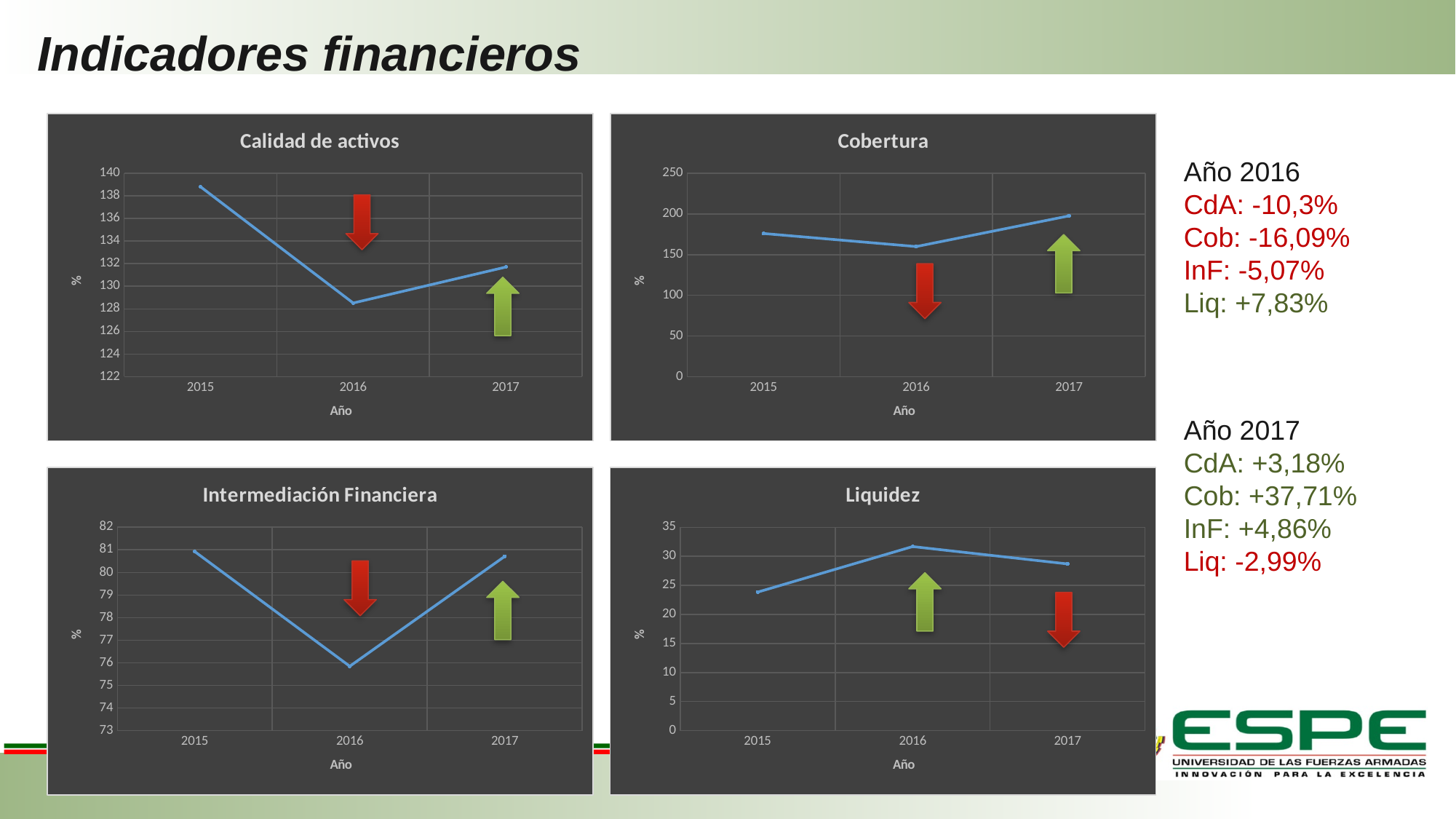
In the 'Intermediación Financiera' chart, which year has the lowest value? 2016 In the 'Cobertura' chart, is the value for 2017 greater or less than 150? greater In the 'Calidad de activos' chart, is the value for 2016 greater or less than 130? less In the 'Calidad de activos' chart, which year has the lowest value? 2016 In the 'Liquidez' chart, which year has the highest value? 2016 In the 'Cobertura' chart, which is larger, the value for 2015 or the value for 2016? 2015 In the 'Calidad de activos' chart, which year has the highest value? 2015 In the 'Liquidez' chart, how many years are plotted on the x axis? 3 In the 'Intermediación Financiera' chart, is the value for 2016 greater or less than 77? less In the 'Liquidez' chart, does the value rise or fall from 2016 to 2017? fall In the 'Cobertura' chart, which year has the highest value? 2017 What kind of chart is the 'Calidad de activos' chart? line chart